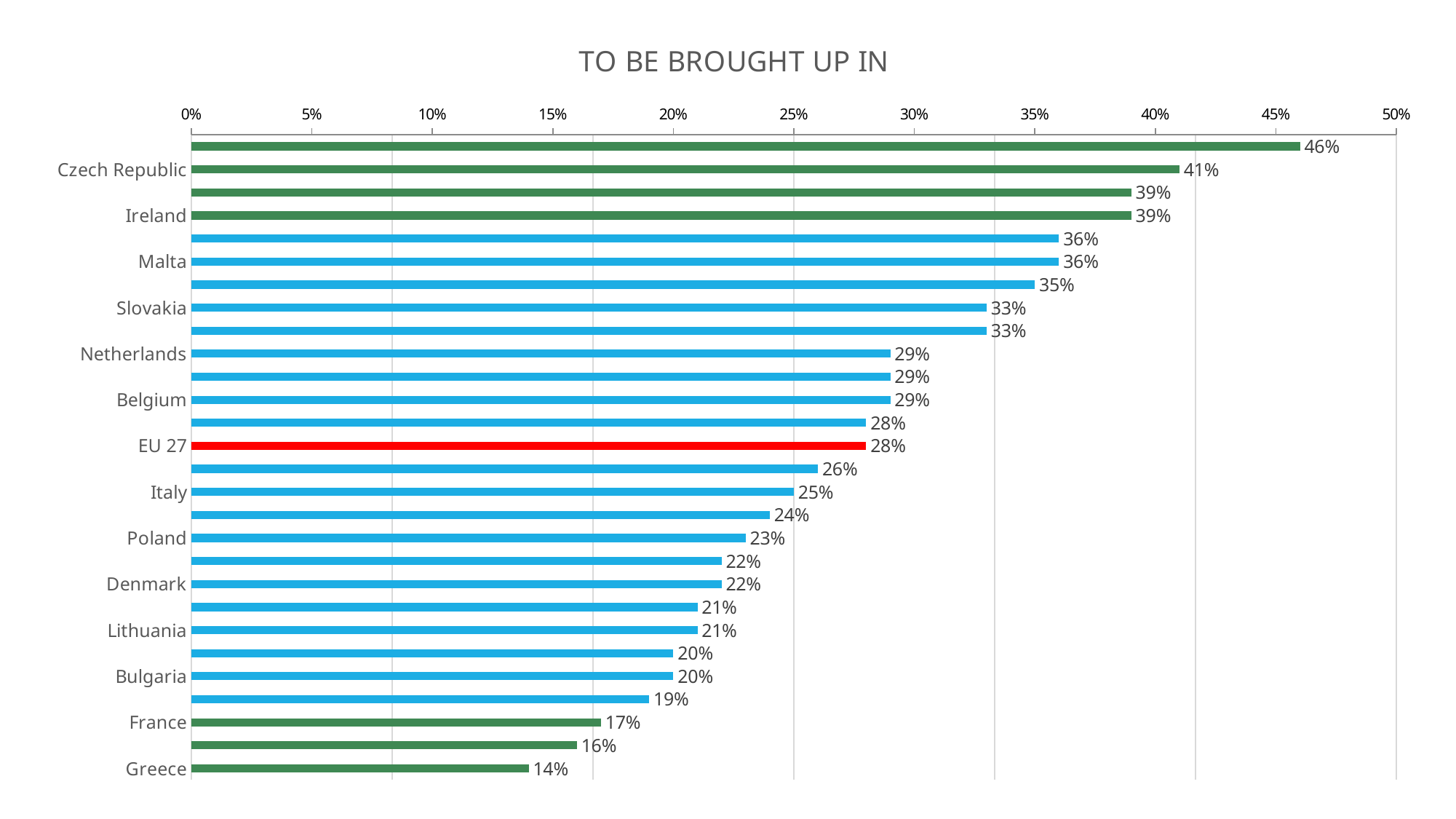
Which labelled category has the lowest value? Greece What colour is the bar for EU 27? red What is the value for Greece? 14% What is the value for Ireland? 39% What is the value for Czech Republic? 41% What is the difference between the values for Ireland and Italy? 14% Which has a larger value, Denmark or Lithuania? Denmark How many bars are plotted in the chart? 28 What is the value for EU 27? 28% What kind of chart is shown on the slide? bar chart Which has a larger value, Malta or Slovakia? Malta What is the difference between the values for Czech Republic and Greece? 27%